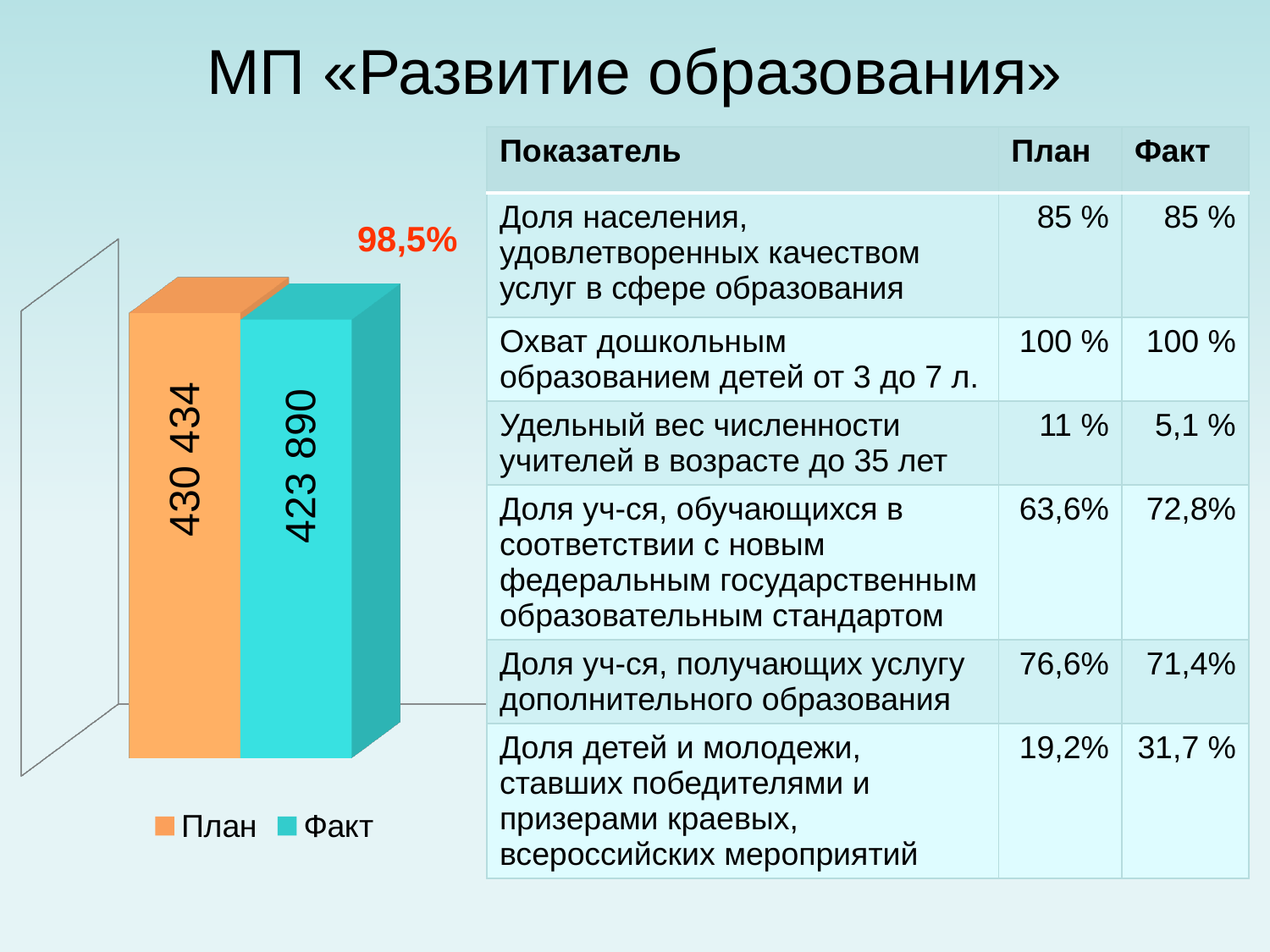
What is the value of the План bar in the chart? 430 434 Which series has the lowest value in the chart? Факт What percentage is printed in red above the bars in the chart? 98,5% How many bars are plotted in the chart? 2 How many series does the chart legend list? 2 Which series has the highest value in the chart? План What is the value of the Факт bar in the chart? 423 890 What colour is the Факт bar in the chart? Turquoise What kind of chart is shown on the slide? Bar chart Which bar in the chart is taller, План or Факт? План What is the difference between the План and Факт values in the chart? 6 544